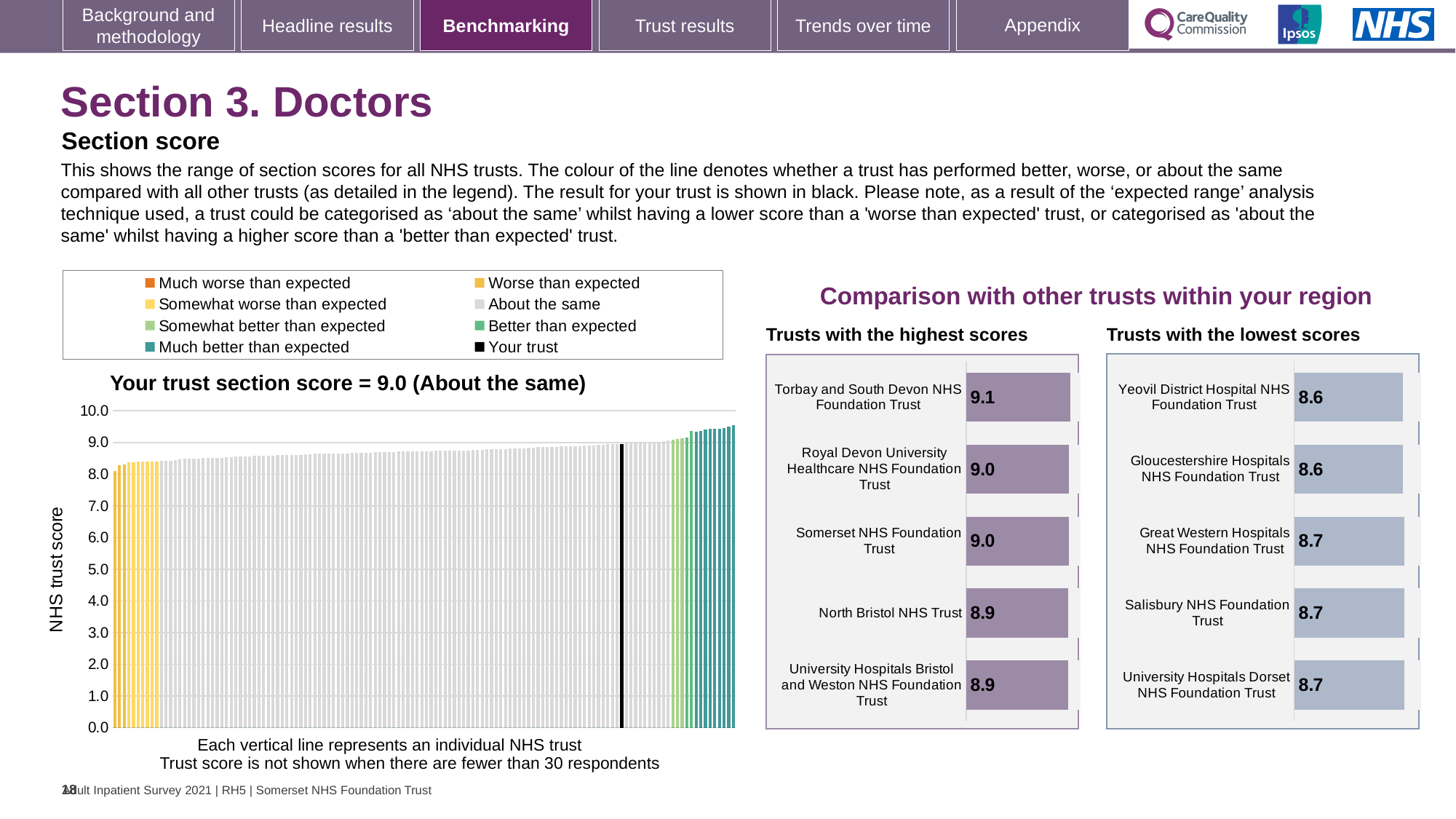
How many trusts are listed in the 'Trusts with the lowest scores' chart? 5 In the 'Trusts with the highest scores' chart, what is the score for North Bristol NHS Trust? 8.9 In the 'Trusts with the highest scores' chart, what is the difference between the scores of Torbay and South Devon NHS Foundation Trust and North Bristol NHS Trust? 0.2 In the main section score chart on the left, what is the section score for your trust? 9.0 In the 'Trusts with the lowest scores' chart, what is the difference between the scores of Great Western Hospitals NHS Foundation Trust and Yeovil District Hospital NHS Foundation Trust? 0.1 In the main section score chart on the left, do the trust scores rise or fall from left to right along the x axis? rise How many entries does the legend above the main section score chart list? 8 In the 'Trusts with the highest scores' chart, what is the score for Torbay and South Devon NHS Foundation Trust? 9.1 In the 'Trusts with the highest scores' chart, which trust has the highest score? Torbay and South Devon NHS Foundation Trust In the 'Trusts with the lowest scores' chart, what is the score for Salisbury NHS Foundation Trust? 8.7 Which is larger: the score for Torbay and South Devon NHS Foundation Trust in the 'Trusts with the highest scores' chart, or the score for Yeovil District Hospital NHS Foundation Trust in the 'Trusts with the lowest scores' chart? Torbay and South Devon NHS Foundation Trust In the 'Trusts with the lowest scores' chart, what is the score for Yeovil District Hospital NHS Foundation Trust? 8.6